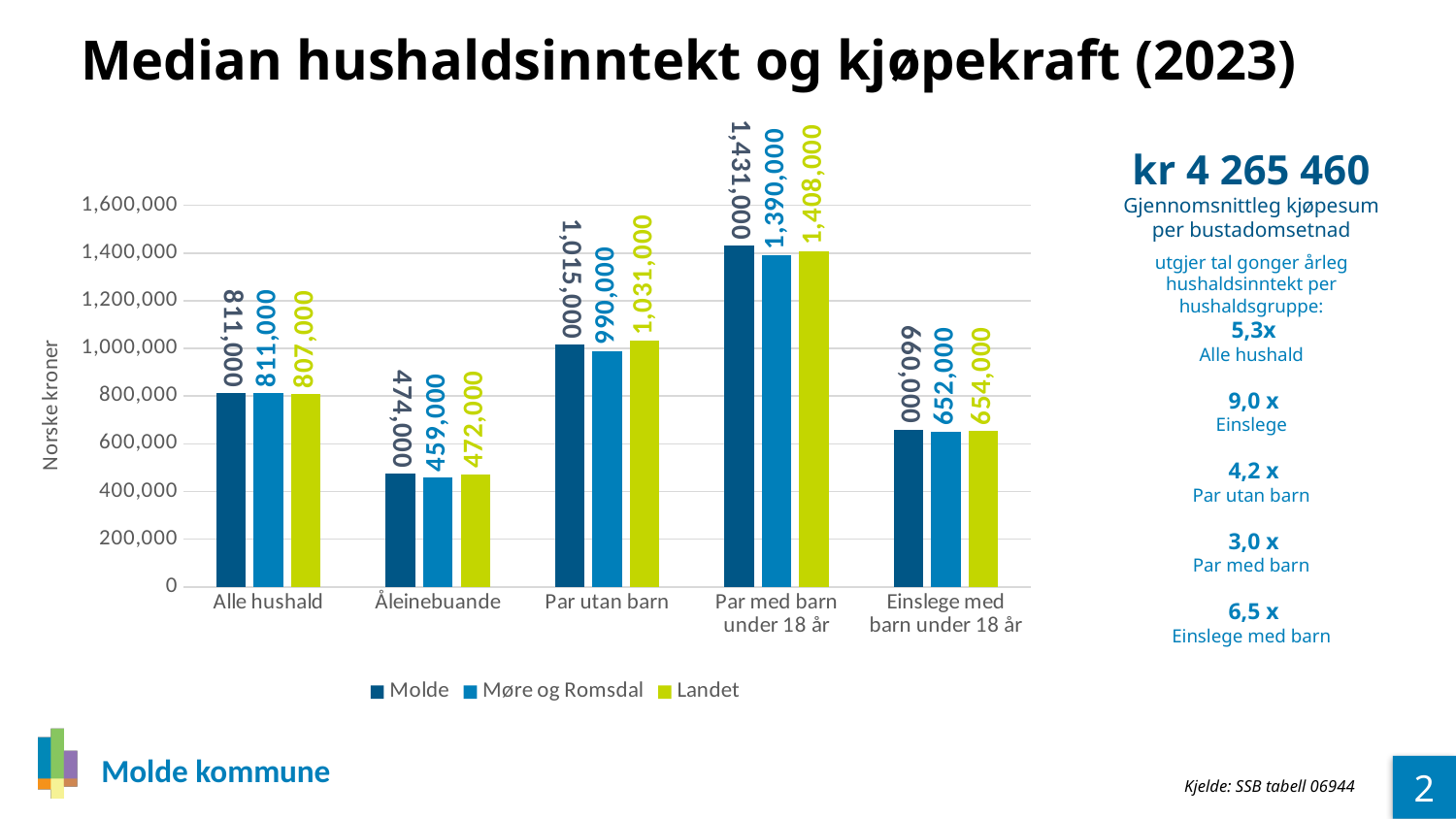
In the 'Par utan barn' category, which is larger: the value for Molde or the value for Landet? Landet What is the value for Møre og Romsdal in the 'Par utan barn' category? 990,000 How many categories are shown on the x axis? 5 What is the label on the vertical axis of the chart? Norske kroner Which category has the lowest value for Landet? Åleinebuande Is the value for Molde in the 'Einslege med barn under 18 år' category greater or less than 800,000? less What kind of chart is shown on the slide? bar chart What is the difference between the Molde and Møre og Romsdal values in the 'Par med barn under 18 år' category? 41,000 How many series does the legend list? 3 Which category has the highest value for Molde? Par med barn under 18 år What is the value for Landet in the 'Åleinebuande' category? 472,000 What is the value for Molde in the 'Par med barn under 18 år' category? 1,431,000